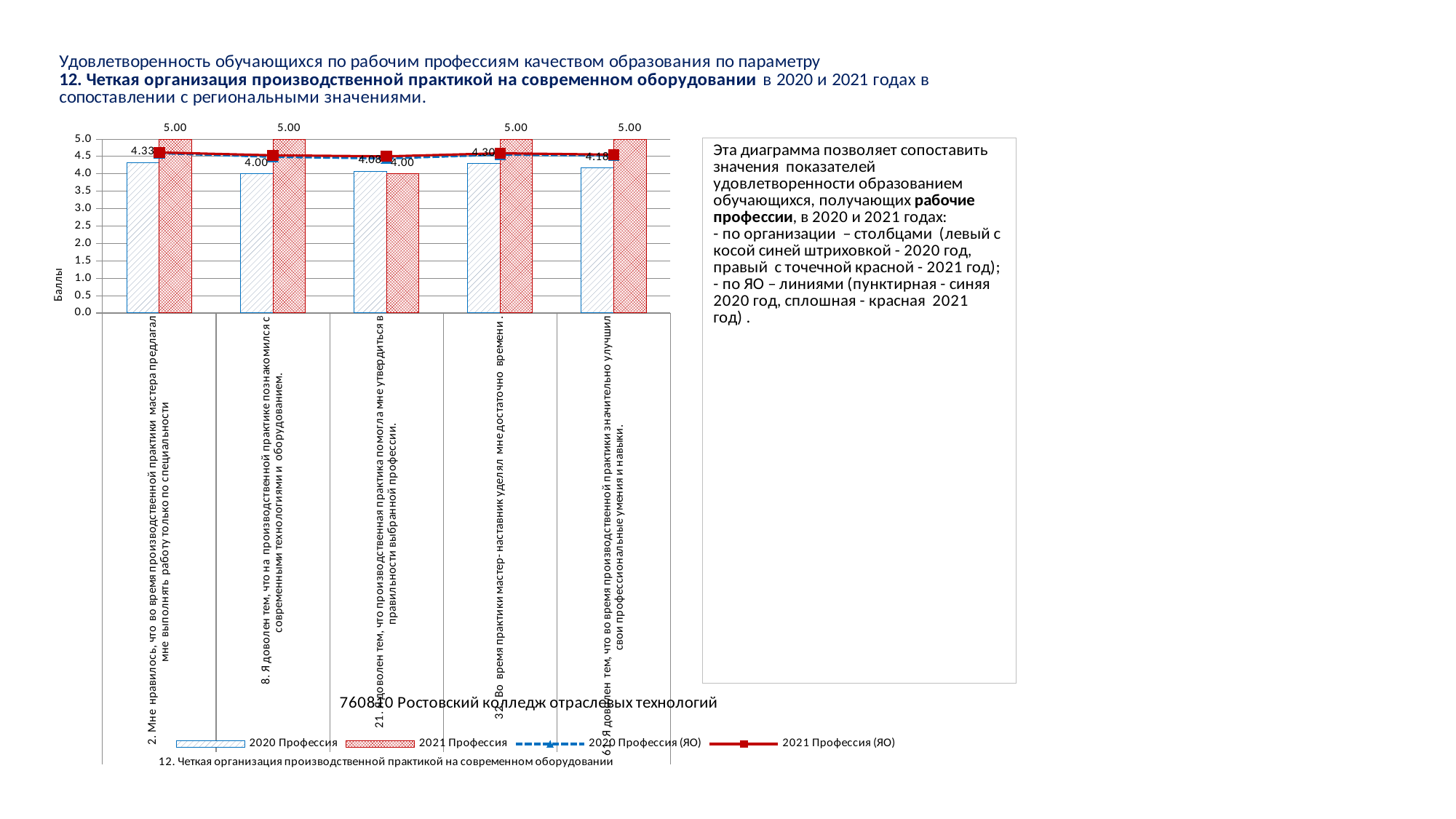
What is the title of the vertical axis of the chart? Баллы Which category has the lowest 2020 Профессия value? 8. Я доволен тем, что на производственной практике познакомился с современными технологиями и оборудованием How many series does the chart legend list? 4 What is the value of the 2021 Профессия bar for category 32 (Во время практики мастер-наставник уделял мне достаточно времени)? 5.00 What is the value of the 2021 Профессия bar for category 21 (Я доволен тем, что производственная практика помогла мне утвердиться в правильности выбранной профессии)? 4.00 Which category has the lowest 2021 Профессия value? 21. Я доволен тем, что производственная практика помогла мне утвердиться в правильности выбранной профессии What is the value of the 2020 Профессия bar for category 2 (Мне нравилось, что во время производственной практики мастера предлагал мне выполнять работу только по специальности)? 4.33 What is the difference between the 2021 Профессия and 2020 Профессия values for category 2? 0.67 How many categories (questions) are shown on the x axis of the chart? 5 What is the value of the 2020 Профессия bar for category 8 (Я доволен тем, что на производственной практике познакомился с современными технологиями и оборудованием)? 4.00 Is the 2020 Профессия value for category 61 greater or less than 4.0? greater For category 21, which is larger: the 2020 Профессия value or the 2021 Профессия value? 2020 Профессия